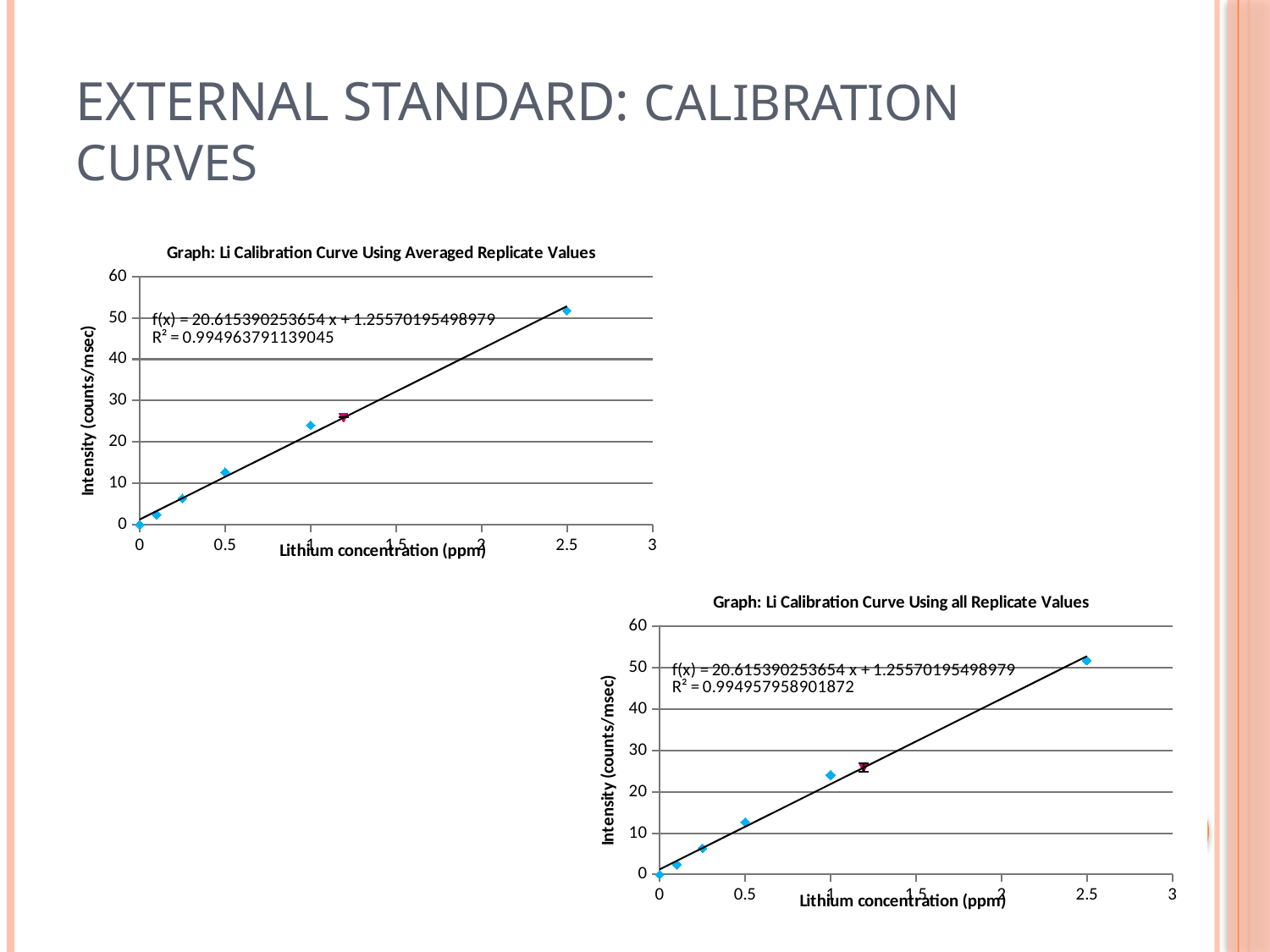
In the bottom chart (all Replicate Values), does intensity rise or fall as lithium concentration increases? Rise In the bottom chart (all Replicate Values), at which lithium concentration is the intensity lowest? 0 ppm In the bottom chart (all Replicate Values), which has the higher intensity: the point at 1 ppm or the point at 2.5 ppm? 2.5 ppm In the bottom chart (all Replicate Values), is the intensity at 1 ppm greater or less than 30 counts/msec? less In the top chart (Averaged Replicate Values), does intensity rise or fall as lithium concentration increases? Rise In the top chart (Averaged Replicate Values), is the intensity at 2.5 ppm greater or less than 40 counts/msec? greater In the top chart (Averaged Replicate Values), at which lithium concentration is the intensity highest? 2.5 ppm What R² value is shown on the top chart (Averaged Replicate Values)? 0.994963791139045 In the top chart (Averaged Replicate Values), is the intensity at 0.5 ppm greater or less than 10 counts/msec? greater What R² value is shown on the bottom chart (all Replicate Values)? 0.994957958901872 What kind of chart is the top chart titled 'Graph: Li Calibration Curve Using Averaged Replicate Values'? Scatter chart with a linear trendline How many blue diamond data points are plotted in the top chart (Averaged Replicate Values)? 6